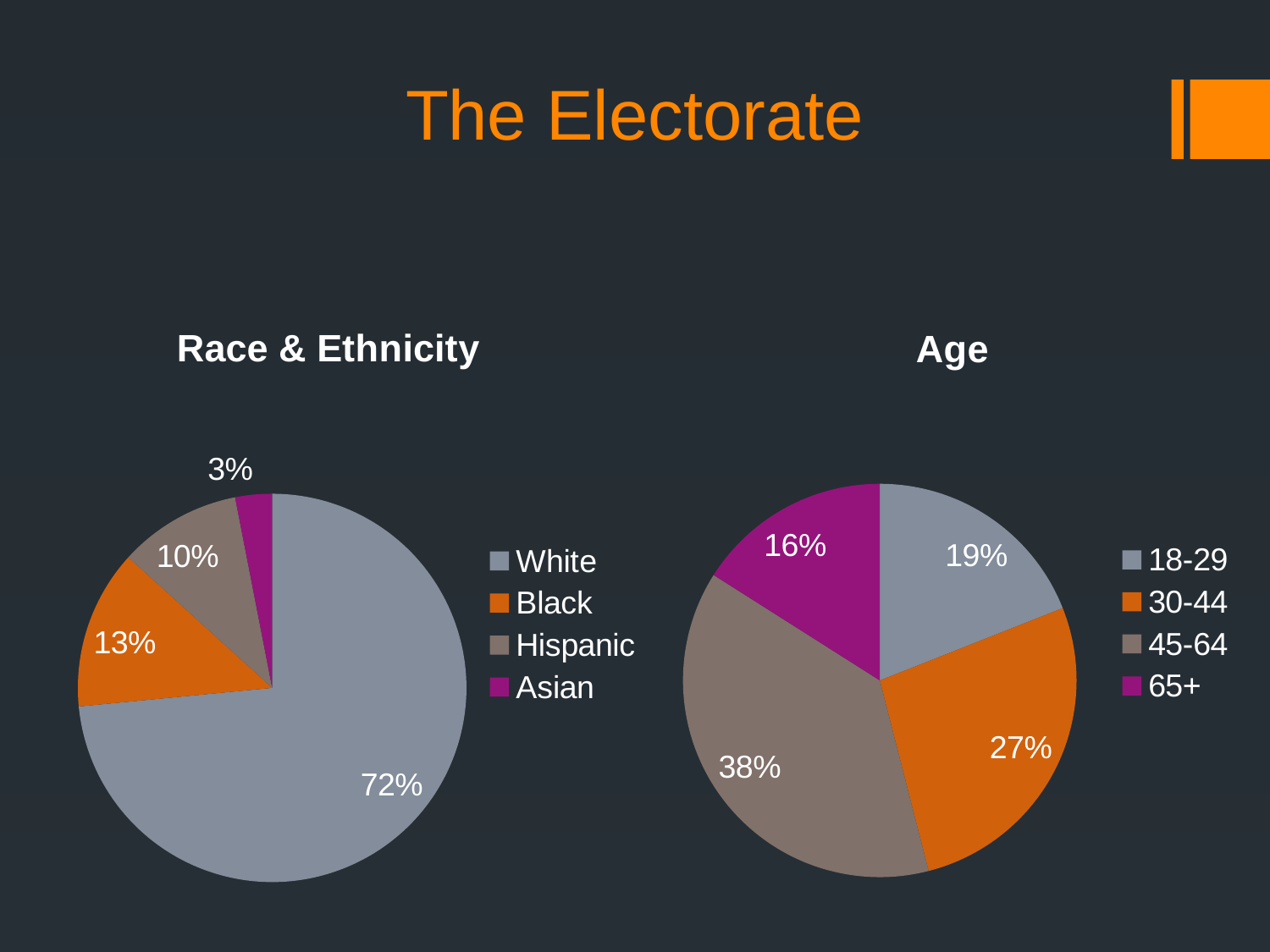
In the Age chart, what share of the electorate is aged 45-64? 38% In the Race & Ethnicity chart, what share of the electorate is Asian? 3% In the Race & Ethnicity chart, what share of the electorate is Black? 13% In the Age chart, what share of the electorate is aged 65+? 16% In the Race & Ethnicity chart, what is the difference between the Black and Hispanic shares? 3% In the Age chart, which age group has the largest slice? 45-64 In the Race & Ethnicity chart, how many slices does the pie have? 4 What type of chart is the Age chart? Pie chart In the Race & Ethnicity chart, what share of the electorate is White? 72% In the Age chart, which is larger, the 18-29 slice or the 30-44 slice? 30-44 In the Race & Ethnicity chart, which group has the smallest slice? Asian In the Age chart, what is the difference between the 45-64 and 30-44 shares? 11%